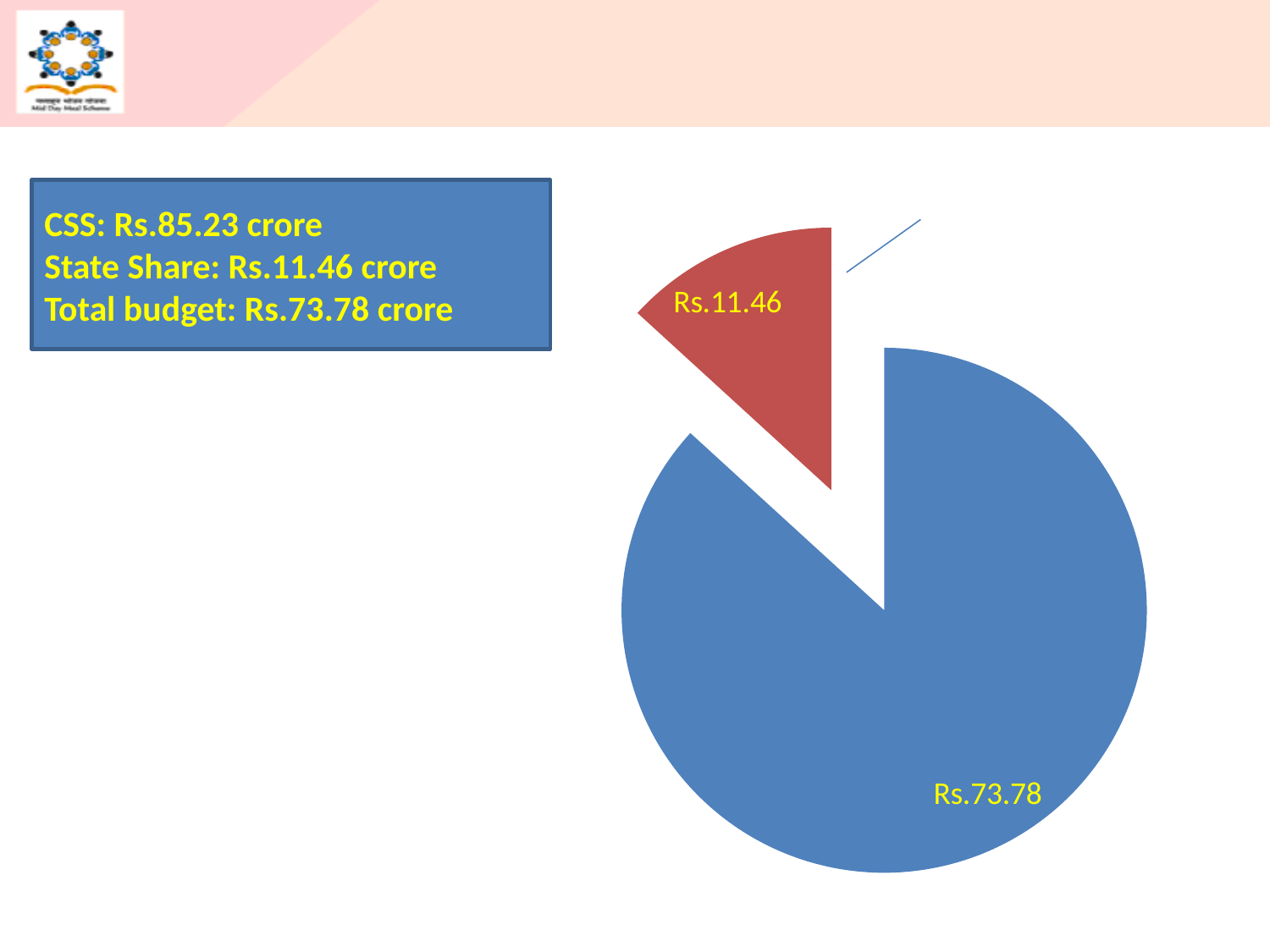
What colour is the slice labelled Rs.11.46? red What is the value printed on the largest slice of the pie chart? Rs.73.78 What is the difference between the two slice values, Rs.73.78 and Rs.11.46? Rs.62.32 What type of chart is shown on the slide? pie chart Which slice is larger, the one labelled Rs.73.78 or the one labelled Rs.11.46? Rs.73.78 Which slice is pulled out (exploded) from the pie chart? Rs.11.46 What value is labelled on the red slice of the pie chart? Rs.11.46 What is the value printed on the smallest slice of the pie chart? Rs.11.46 How many slices does the pie chart have? 2 What is the sum of the two slice values shown on the pie chart? Rs.85.24 What value is labelled on the blue slice of the pie chart? Rs.73.78